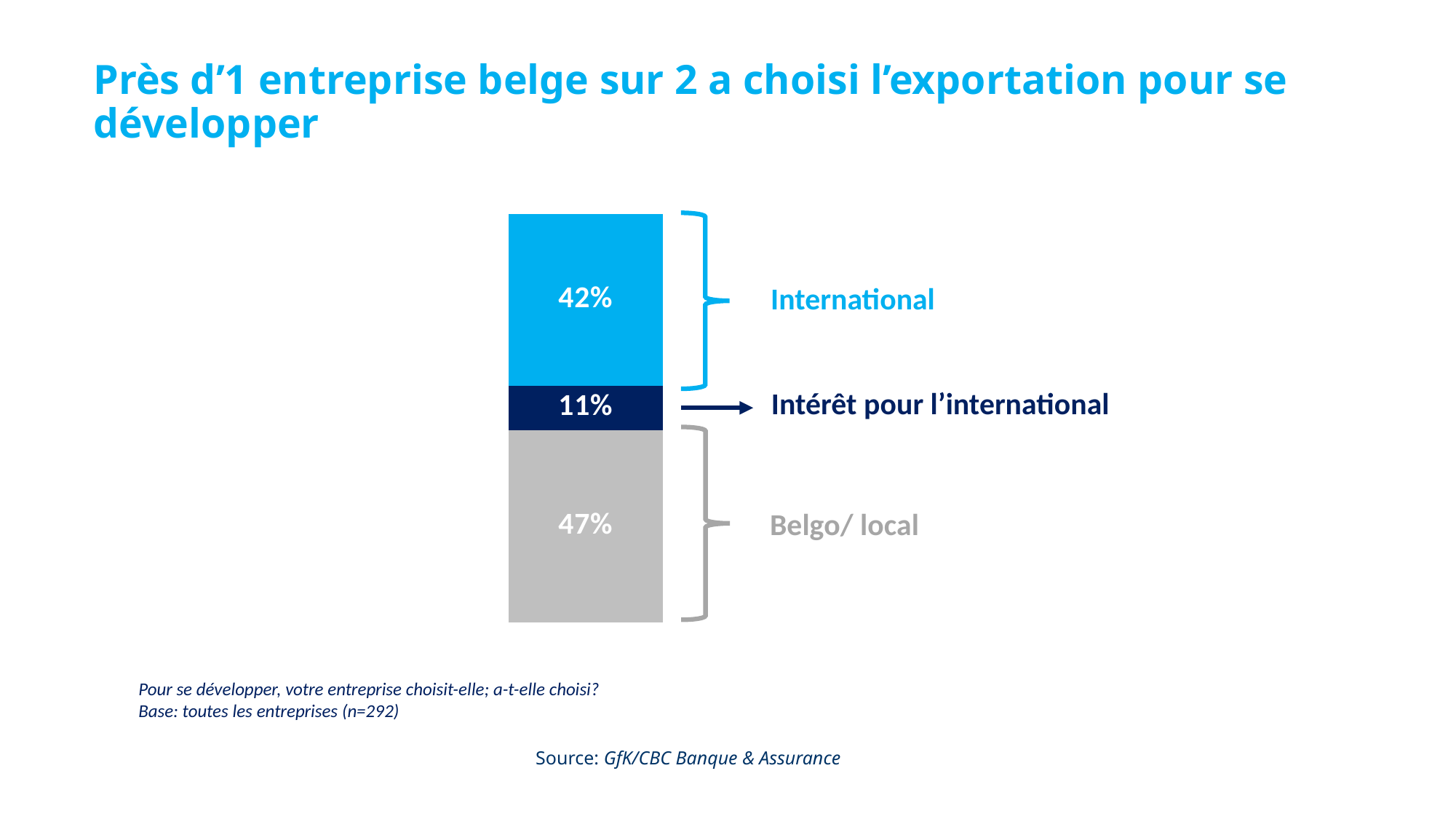
What percentage of companies are labelled Intérêt pour l'international? 11% What is the difference between the Belgo/ local share and the International share? 5% What kind of chart is shown on the slide? Stacked bar chart What colour is the Belgo/ local segment of the bar? Grey What percentage of companies chose International? 42% How many segments make up the stacked bar? 3 What is the difference between the International share and the Intérêt pour l'international share? 31% Which is larger, the International share or the Belgo/ local share? Belgo/ local What percentage of companies chose Belgo/ local? 47% What is the total of the three segments in the stacked bar? 100% Which segment of the stacked bar has the largest share? Belgo/ local Which segment of the stacked bar has the smallest share? Intérêt pour l'international